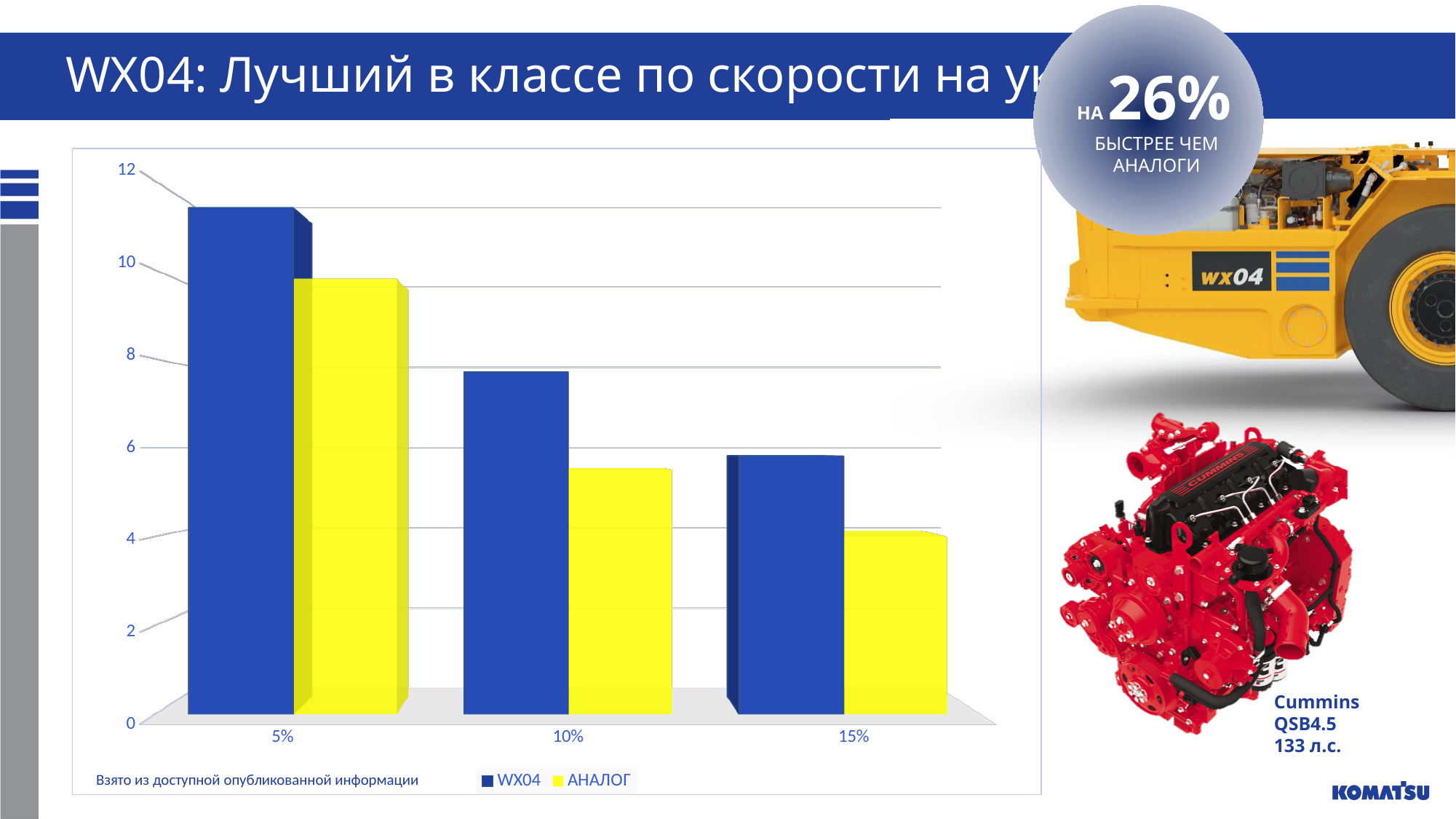
At 15%, which series has the larger value, WX04 or АНАЛОГ? WX04 Is the value for АНАЛОГ at 15% greater or less than 6? less What are the two series named in the chart legend? WX04 and АНАЛОГ How many categories are shown on the x axis of the chart? 3 Which series is shown in yellow in the chart? АНАЛОГ Is the value for WX04 at 10% greater or less than 6? greater Do the WX04 values rise or fall as the x axis goes from 5% to 15%? fall Is the value for АНАЛОГ at 5% greater or less than 8? greater How many series does the chart legend list? 2 What kind of chart is shown on the slide? bar chart